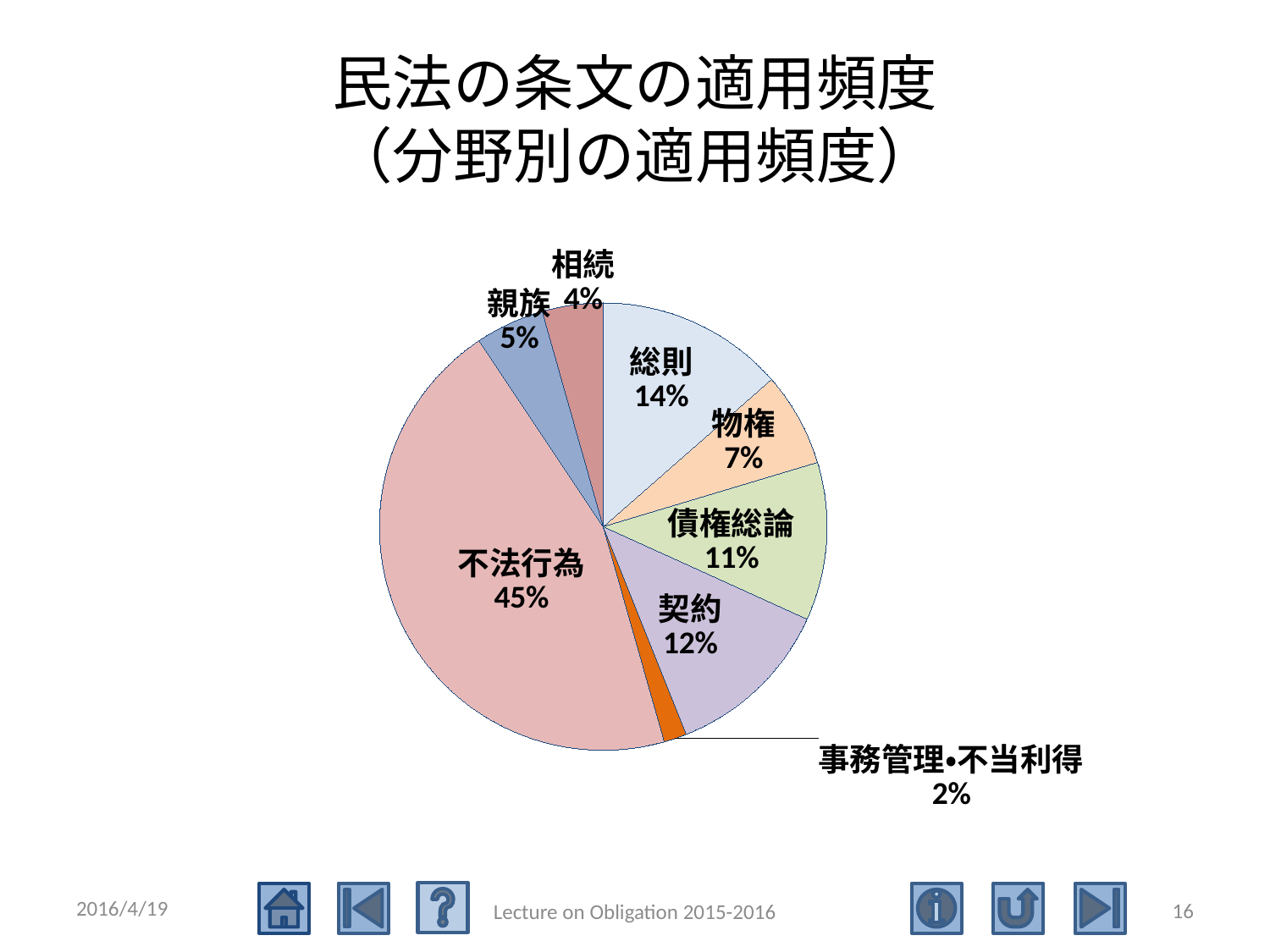
What share of the pie does 不法行為 have? 45% What is the combined share of 総則 and 物権? 21% Which category has the largest slice of the pie? 不法行為 How many categories are shown in the pie chart? 8 Which category has the smallest slice of the pie? 事務管理•不当利得 What is the title of the slide containing the chart? 民法の条文の適用頻度（分野別の適用頻度） What is the value shown for 債権総論? 11% What is the value shown for 総則? 14% What is the value shown for 事務管理•不当利得? 2% What kind of chart is shown on the slide? pie chart Which is larger, the share of 親族 or the share of 相続? 親族 What is the difference between the shares of 契約 and 物権? 5%